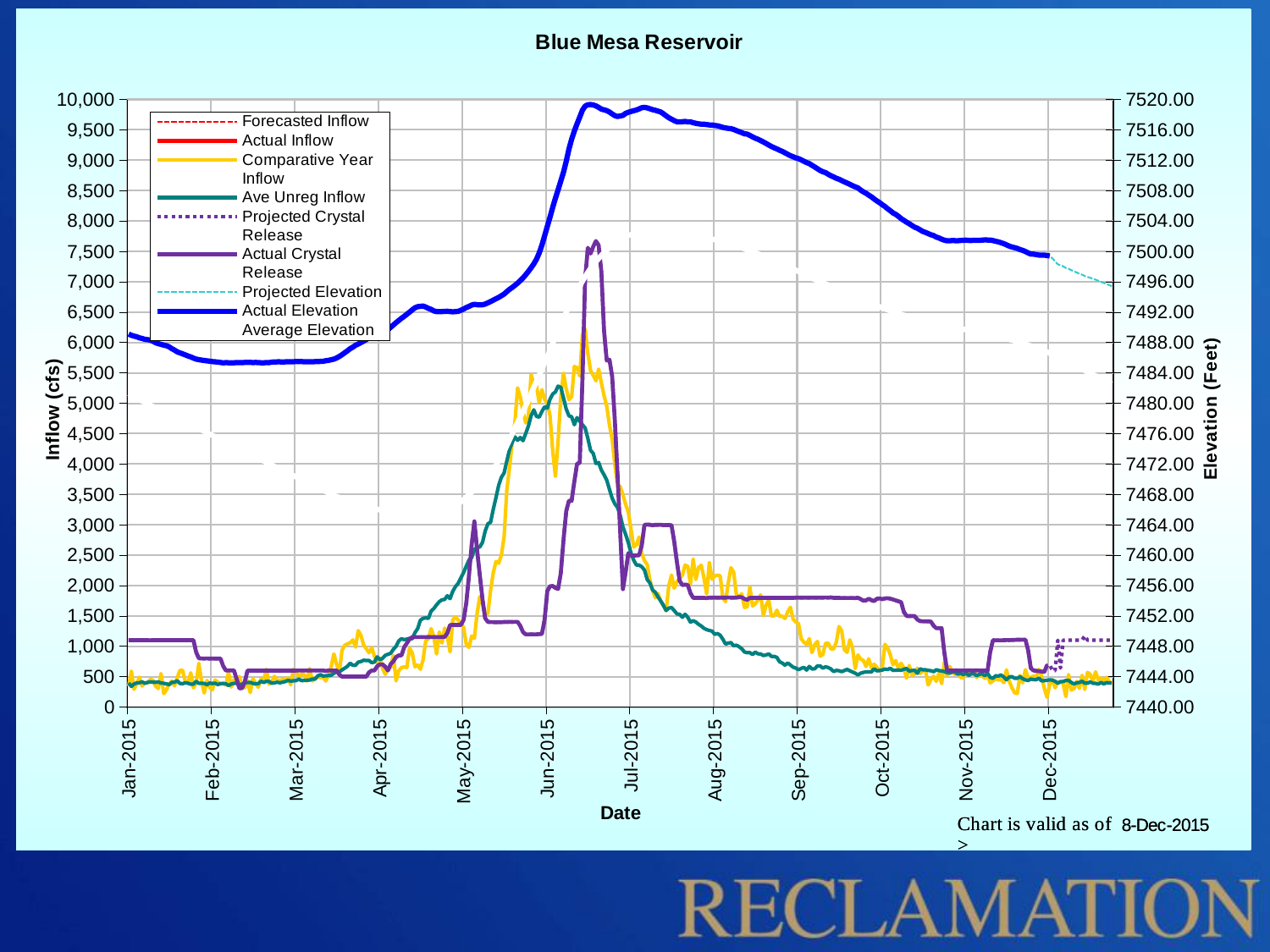
Does the Actual Elevation line rise or fall between July and December 2015? fall Is the peak of the Actual Crystal Release line in late June greater or less than 7,000 cfs? greater What is the label of the right-hand vertical axis? Elevation (Feet) How many month labels are shown along the Date axis? 12 How many series does the legend list? 9 Which reaches a higher peak inflow value: the Actual Crystal Release line or the Ave Unreg Inflow line? Actual Crystal Release Is the Actual Elevation in mid-February greater or less than 7488.00 feet? less What kind of chart is shown on the slide? line chart Is the Actual Crystal Release during August and September greater or less than 2,000 cfs? less What is the title of the chart? Blue Mesa Reservoir